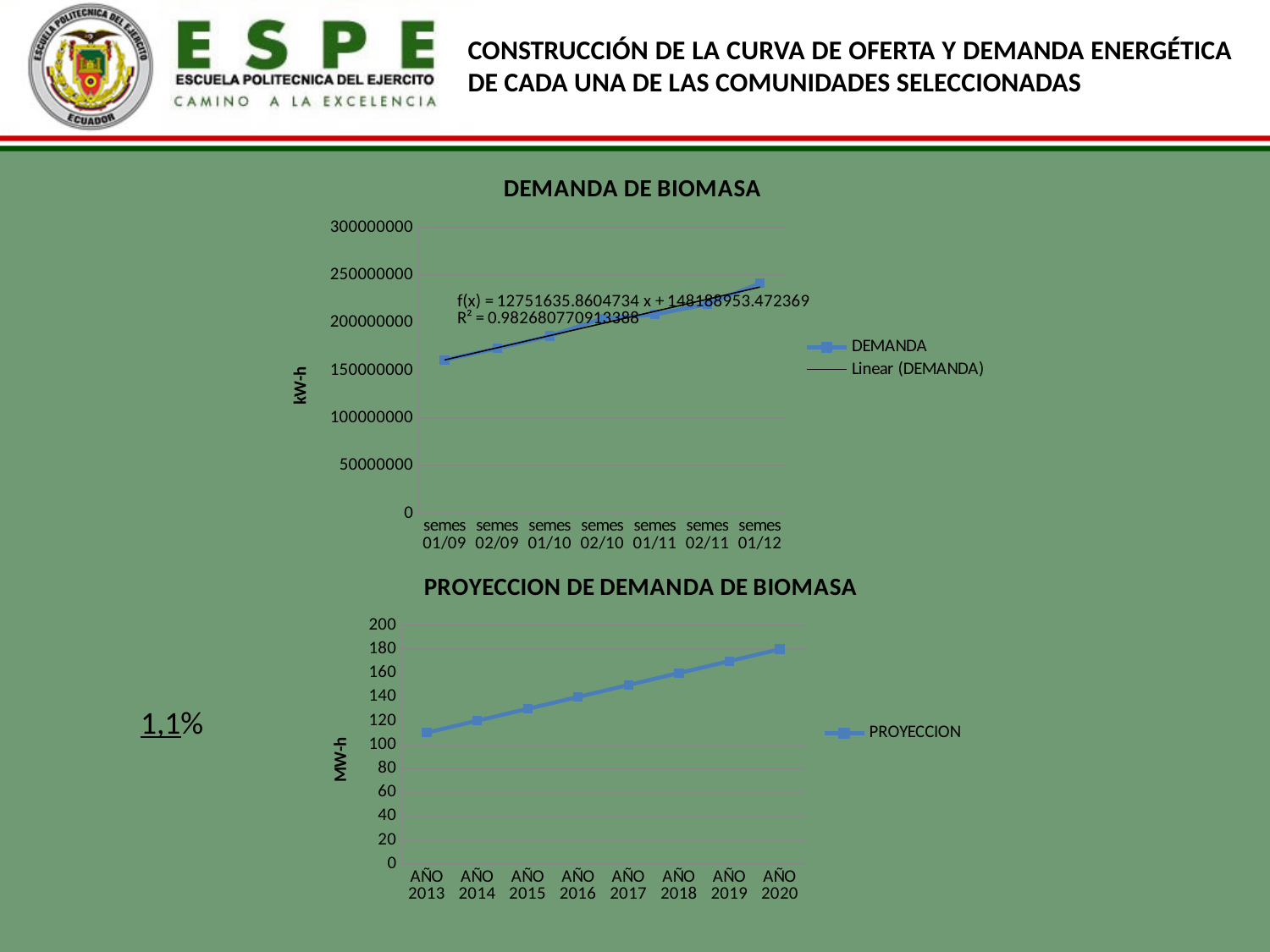
In the "DEMANDA DE BIOMASA" chart, is the value for semes 01/09 greater or less than 200000000? less In the "PROYECCION DE DEMANDA DE BIOMASA" chart, is the value for AÑO 2020 greater or less than 200? less What is the y-axis label of the "PROYECCION DE DEMANDA DE BIOMASA" chart? MW-h In the "DEMANDA DE BIOMASA" chart, which semester has the lowest demand? semes 01/09 In the "DEMANDA DE BIOMASA" chart, how many semesters are plotted on the x axis? 7 What type of chart is the "DEMANDA DE BIOMASA" chart? line chart How many entries does the legend of the "DEMANDA DE BIOMASA" chart list? 2 In the "DEMANDA DE BIOMASA" chart, which semester has the highest demand? semes 01/12 In the "PROYECCION DE DEMANDA DE BIOMASA" chart, how many years are plotted on the x axis? 8 In the "DEMANDA DE BIOMASA" chart, do the values rise or fall from semes 01/09 to semes 01/12? rise In the "PROYECCION DE DEMANDA DE BIOMASA" chart, is the value for AÑO 2013 greater or less than 100? greater